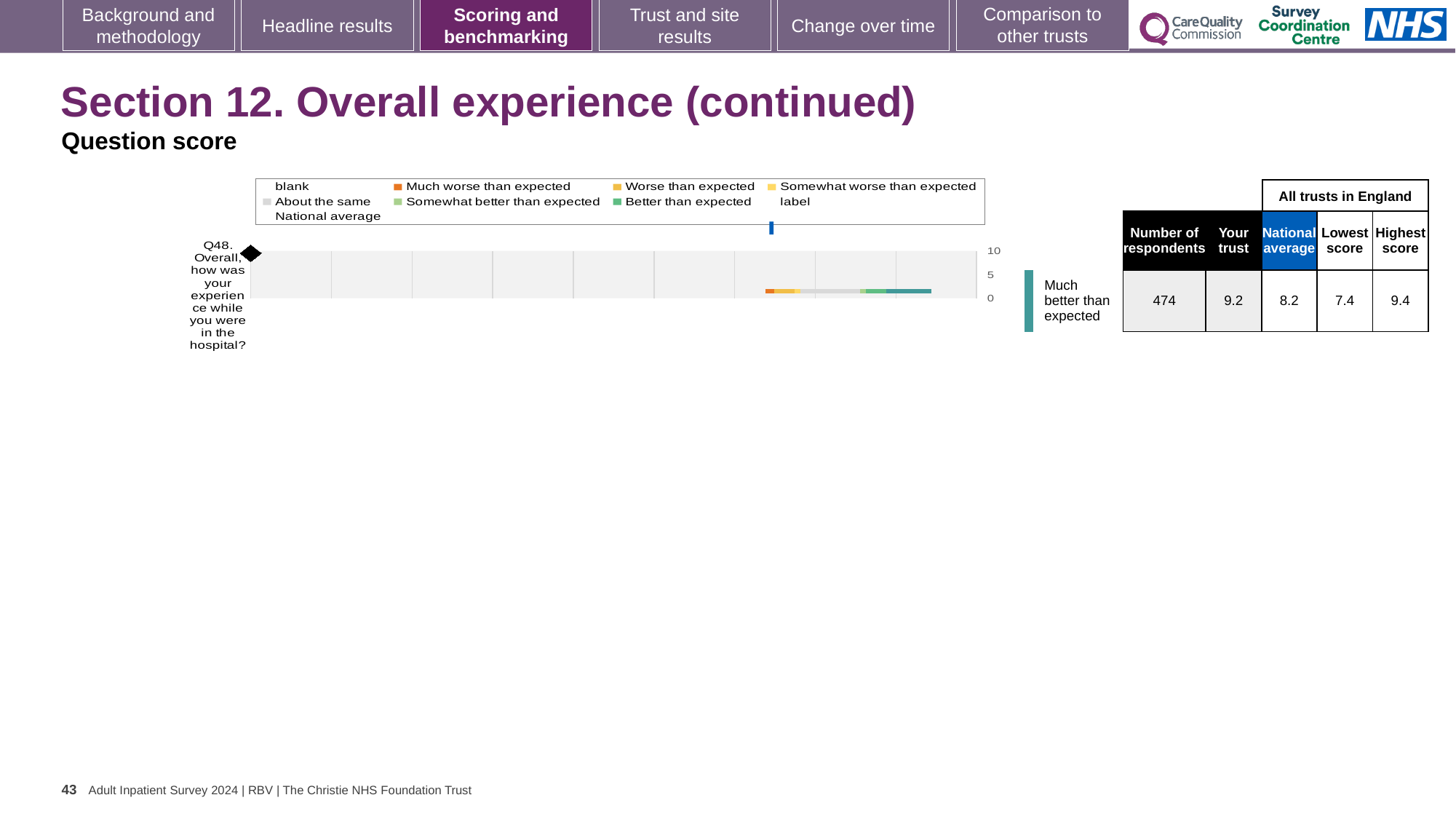
How many respondents answered Q48? 474 How many questions (categories) are plotted on the chart? 1 What is the highest value shown on the chart's axis? 10 What is the difference between Your trust score and the National average for Q48? 1.0 What kind of chart is shown on the slide? Bar chart What is the Highest score among all trusts in England for Q48? 9.4 Which is larger for Q48, Your trust score or the National average? Your trust What is the Lowest score among all trusts in England for Q48? 7.4 Which question is plotted on the chart? Q48. Overall, how was your experience while you were in the hospital? What is the National average score for Q48? 8.2 What is the score for Your trust for Q48? 9.2 What benchmark category is Q48 rated as for this trust? Much better than expected